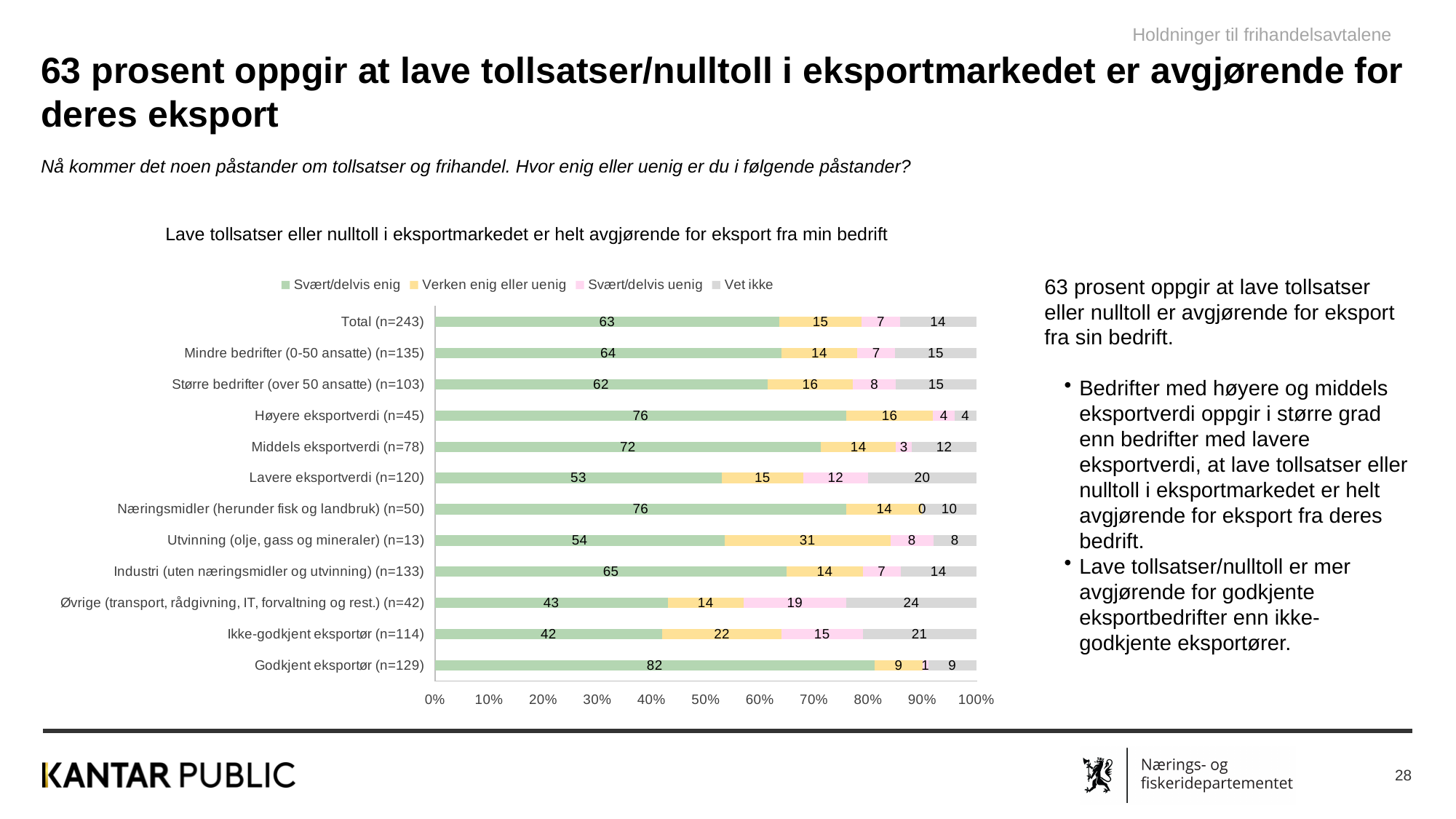
What is the 'Vet ikke' value for Øvrige (transport, rådgivning, IT, forvaltning og rest.) (n=42)? 24 What kind of chart is shown on the slide? Stacked bar chart Which category has the lowest 'Svært/delvis enig' value? Ikke-godkjent eksportør (n=114) What is the title of the chart? Lave tollsatser eller nulltoll i eksportmarkedet er helt avgjørende for eksport fra min bedrift How many series does the legend list? 4 What is the 'Verken enig eller uenig' value for Utvinning (olje, gass og mineraler) (n=13)? 31 What is the difference in 'Svært/delvis enig' between Godkjent eksportør (n=129) and Ikke-godkjent eksportør (n=114)? 40 How many categories (bars) are shown in the chart? 12 What is the 'Svært/delvis enig' value for Total (n=243)? 63 Which has a larger 'Svært/delvis enig' value: Høyere eksportverdi (n=45) or Lavere eksportverdi (n=120)? Høyere eksportverdi (n=45) Which category has the highest 'Svært/delvis enig' value? Godkjent eksportør (n=129) What is the 'Svært/delvis uenig' value for Næringsmidler (herunder fisk og landbruk) (n=50)? 0